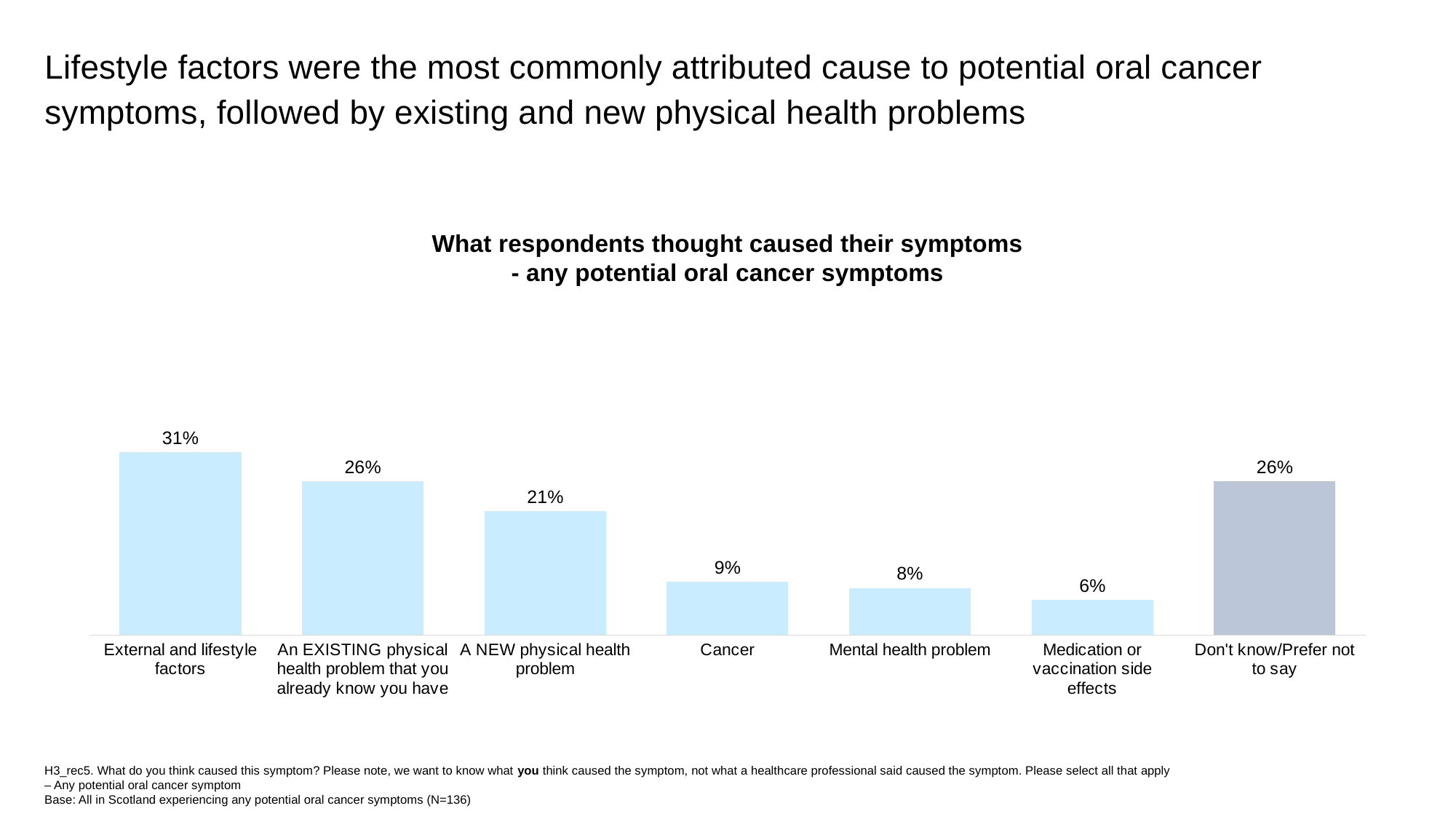
What is the value for 'Medication or vaccination side effects'? 6% What percentage of respondents attributed their symptoms to external and lifestyle factors? 31% What is the value for 'A NEW physical health problem'? 21% Which is larger: the value for 'An EXISTING physical health problem that you already know you have' or the value for 'Cancer'? An EXISTING physical health problem that you already know you have What type of chart is shown on the slide? Bar chart What is the difference between the values for 'Cancer' and 'Mental health problem'? 1% Which category has the highest value? External and lifestyle factors How many categories are shown in the chart? 7 What is the difference between the value for 'External and lifestyle factors' and the value for 'A NEW physical health problem'? 10% Which category has the lowest value? Medication or vaccination side effects What is the title of the chart? What respondents thought caused their symptoms - any potential oral cancer symptoms What percentage of respondents thought cancer caused their symptoms? 9%